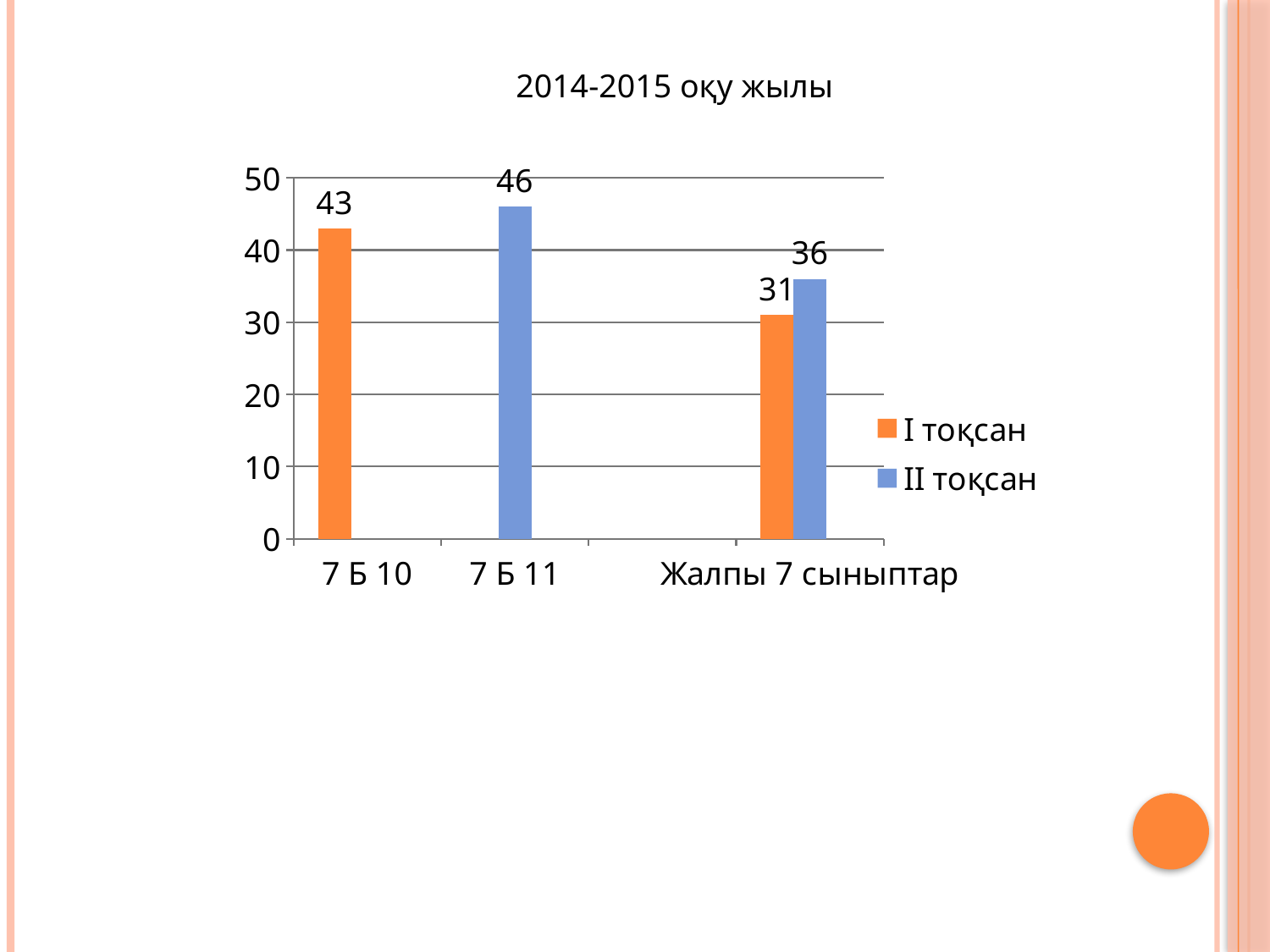
Which bar has the highest value in the chart? II тоқсан for 7 Б 11 How many series does the legend list? 2 What is the difference between II тоқсан and I тоқсан for Жалпы 7 сыныптар? 5 How many categories are shown on the x axis? 3 What is the value of II тоқсан for Жалпы 7 сыныптар? 36 What is the value of I тоқсан for 7 Б 10? 43 What is the title of the chart? 2014-2015 оқу жылы What is the value of I тоқсан for Жалпы 7 сыныптар? 31 What kind of chart is shown on the slide? Bar chart Which is larger: the I тоқсан value for 7 Б 10 or the II тоқсан value for 7 Б 11? II тоқсан value for 7 Б 11 Which bar has the lowest value in the chart? I тоқсан for Жалпы 7 сыныптар What is the value of II тоқсан for 7 Б 11? 46